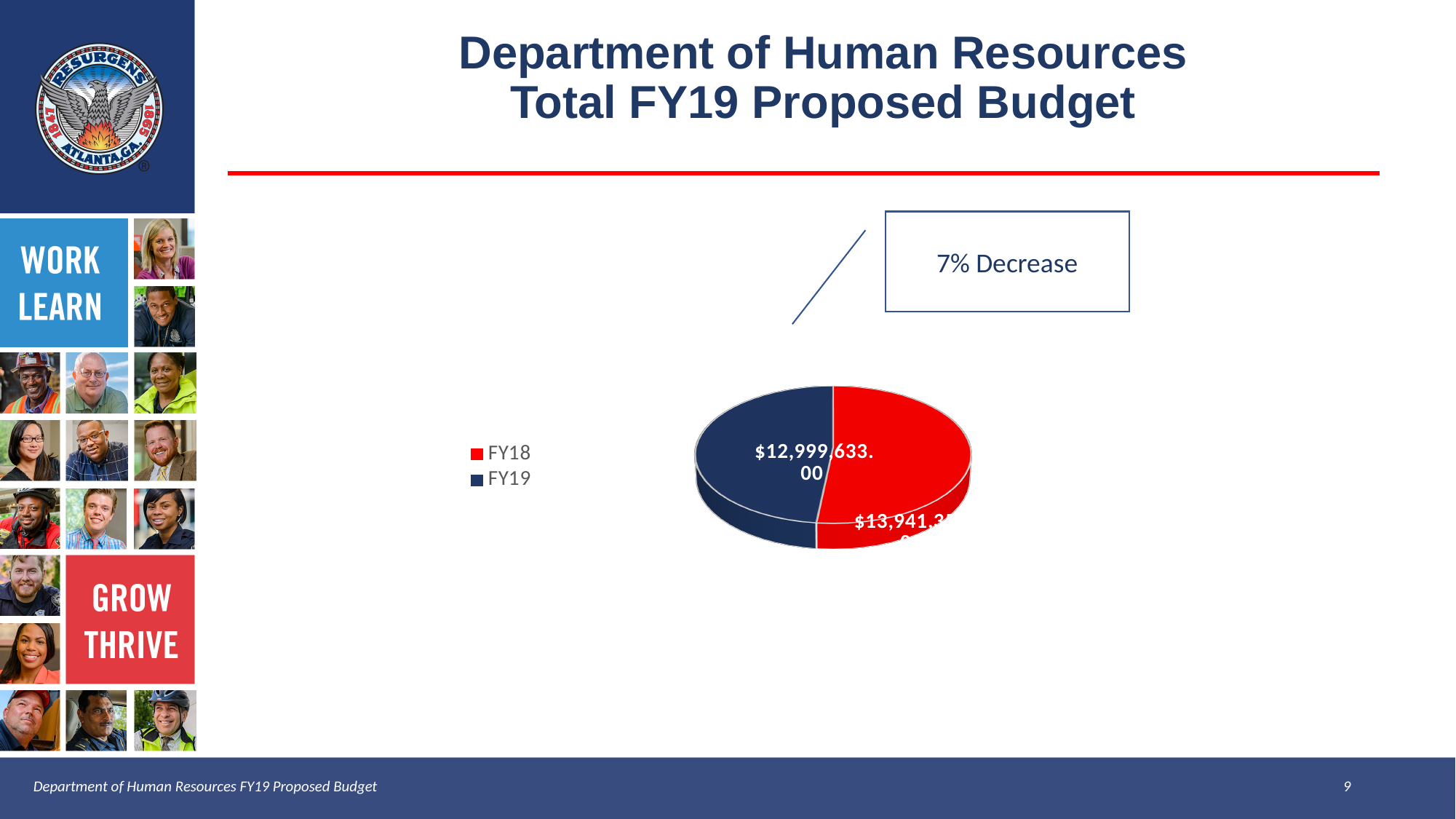
How many slices does the pie chart have? 2 What does the callout box next to the pie chart say? 7% Decrease Which fiscal year has the smallest slice in the pie chart? FY19 What is the value shown for FY19 in the pie chart? $12,999,633.00 Which fiscal year has the largest slice in the pie chart? FY18 What colour is the FY18 slice in the pie chart? red Which fiscal year has the larger slice in the pie chart, FY18 or FY19? FY18 What kind of chart is shown on the slide? pie chart How many entries does the legend of the pie chart list? 2